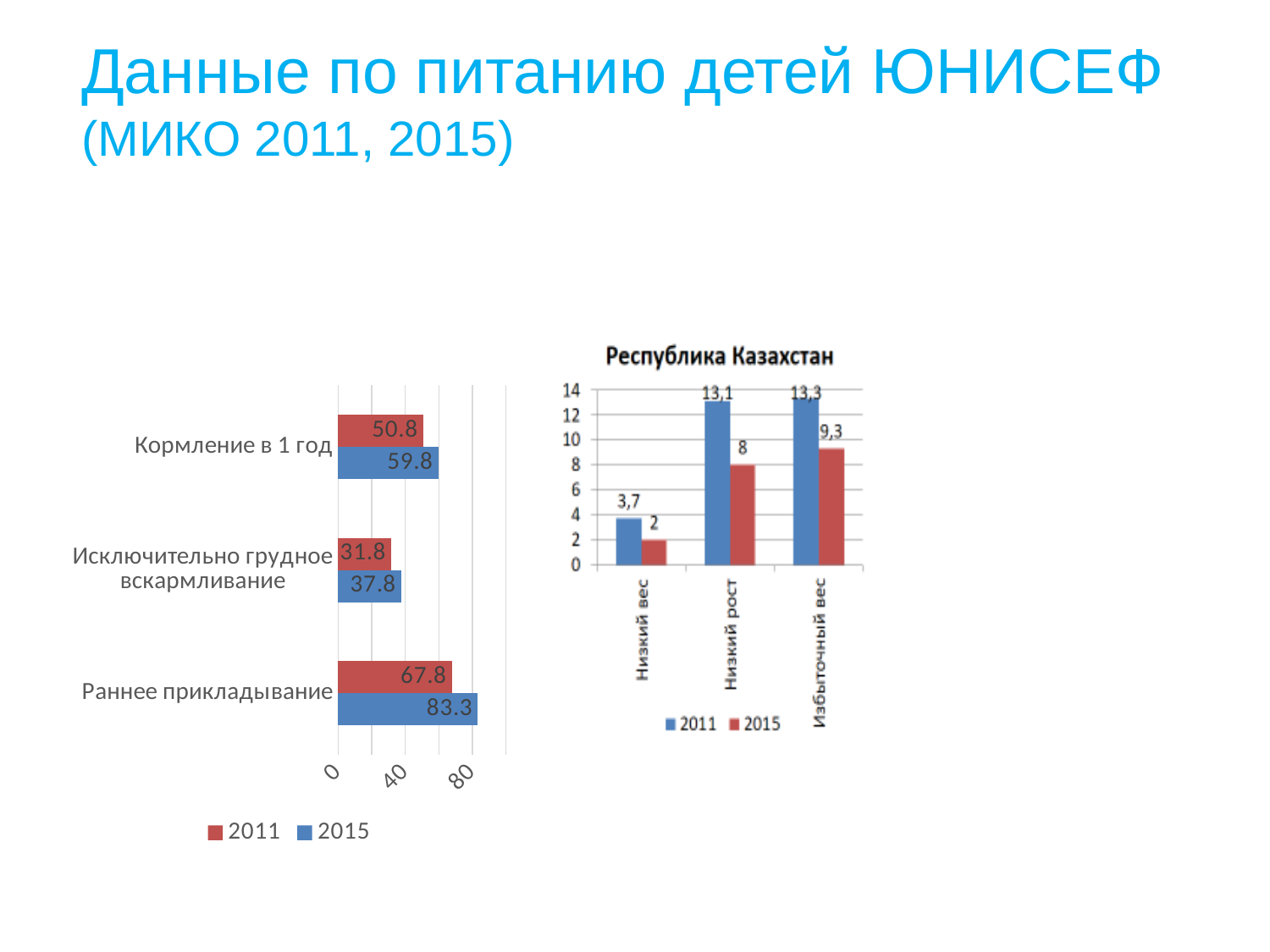
In the chart titled Республика Казахстан, how many series does the legend list? 2 In the left chart, which category has the highest 2015 value? Раннее прикладывание In the chart titled Республика Казахстан, what is the 2011 value for Низкий рост? 13,1 In the left chart, what is the difference between the 2015 and 2011 values for Кормление в 1 год? 9.0 In the chart titled Республика Казахстан, which category has the lowest 2015 value? Низкий вес In the left chart, what is the 2011 value for Кормление в 1 год? 50.8 In the left chart, how many categories are shown? 3 In the left chart, what is the 2011 value for Исключительно грудное вскармливание? 31.8 In the chart titled Республика Казахстан, what is the 2015 value for Избыточный вес? 9,3 What type of chart is the chart titled Республика Казахстан? Bar chart In the left chart, what is the 2015 value for Раннее прикладывание? 83.3 In the chart titled Республика Казахстан, is the 2011 value for Низкий вес larger or the 2015 value? 2011